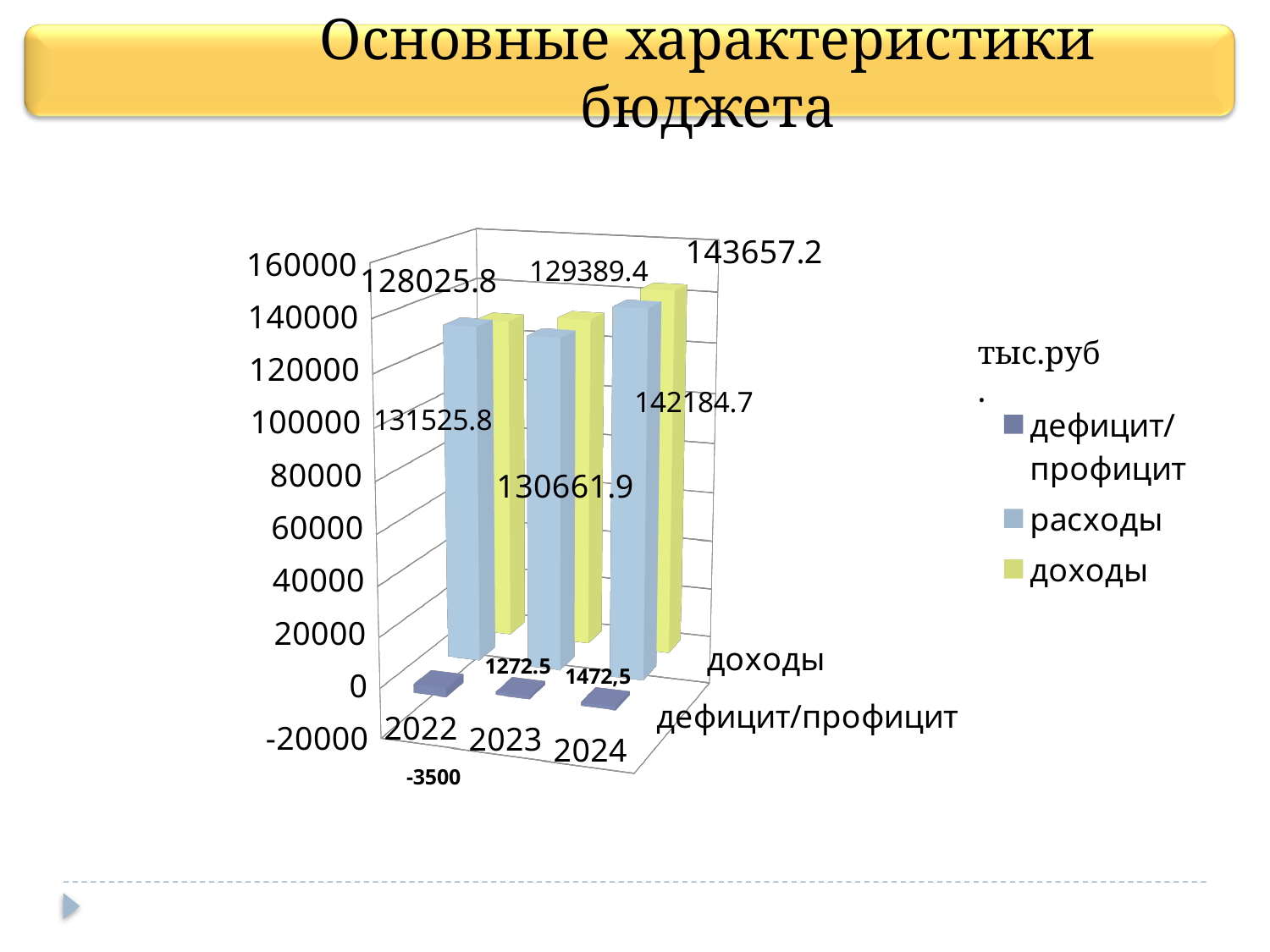
What is the value of доходы for 2022? 128025.8 What type of chart is shown on the slide? bar chart In which year is the value of дефицит/профицит lowest? 2022 How many years are shown on the x axis? 3 What is the value of расходы for 2022? 131525.8 What is the value of дефицит/профицит for 2022? -3500 What is the difference between расходы and доходы in 2022? 3500 In which year are доходы highest? 2024 Which is larger in 2024, доходы or расходы? доходы What is the value of расходы for 2023? 129389.4 How many series does the legend list? 3 What is the value of доходы for 2024? 143657.2